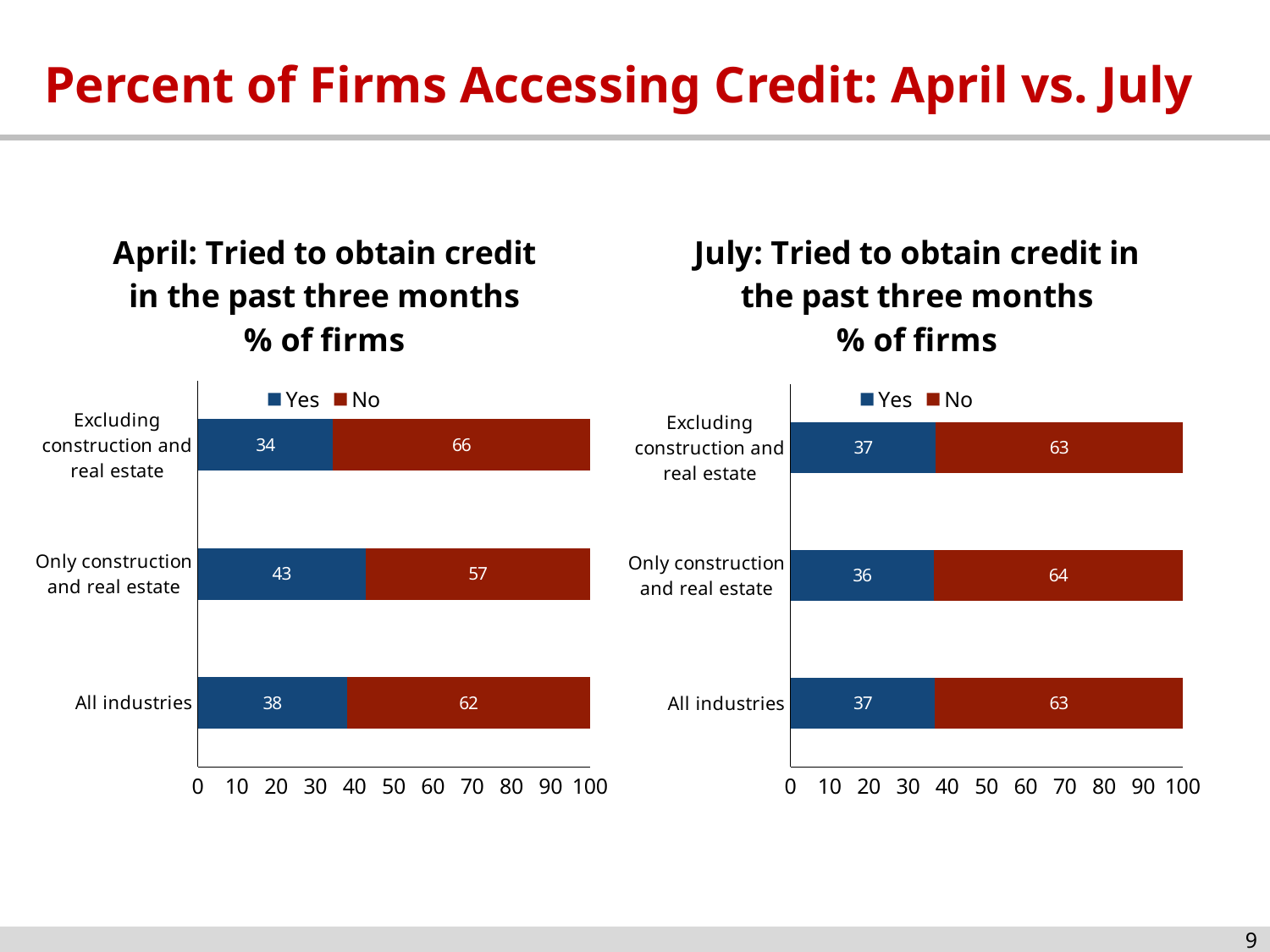
In the April chart, what is the difference between the 'No' and 'Yes' values for 'Excluding construction and real estate'? 32 What type of chart is the April chart? Stacked bar chart How many categories are shown in the April chart? 3 In the April chart, what is the 'No' value for 'All industries'? 62 In the April chart, which category has the lowest 'Yes' value? Excluding construction and real estate How many series does the legend of the July chart list? 2 In the April chart, which category has the highest 'Yes' value? Only construction and real estate In the April chart, what is the 'Yes' value for 'Only construction and real estate'? 43 In the July chart, what is the 'No' value for 'Only construction and real estate'? 64 Which is larger: the 'Yes' value for 'Only construction and real estate' in the April chart or in the July chart? April In the July chart, what is the 'Yes' value for 'Excluding construction and real estate'? 37 In the July chart, what is the total of the stacked bar for 'All industries'? 100